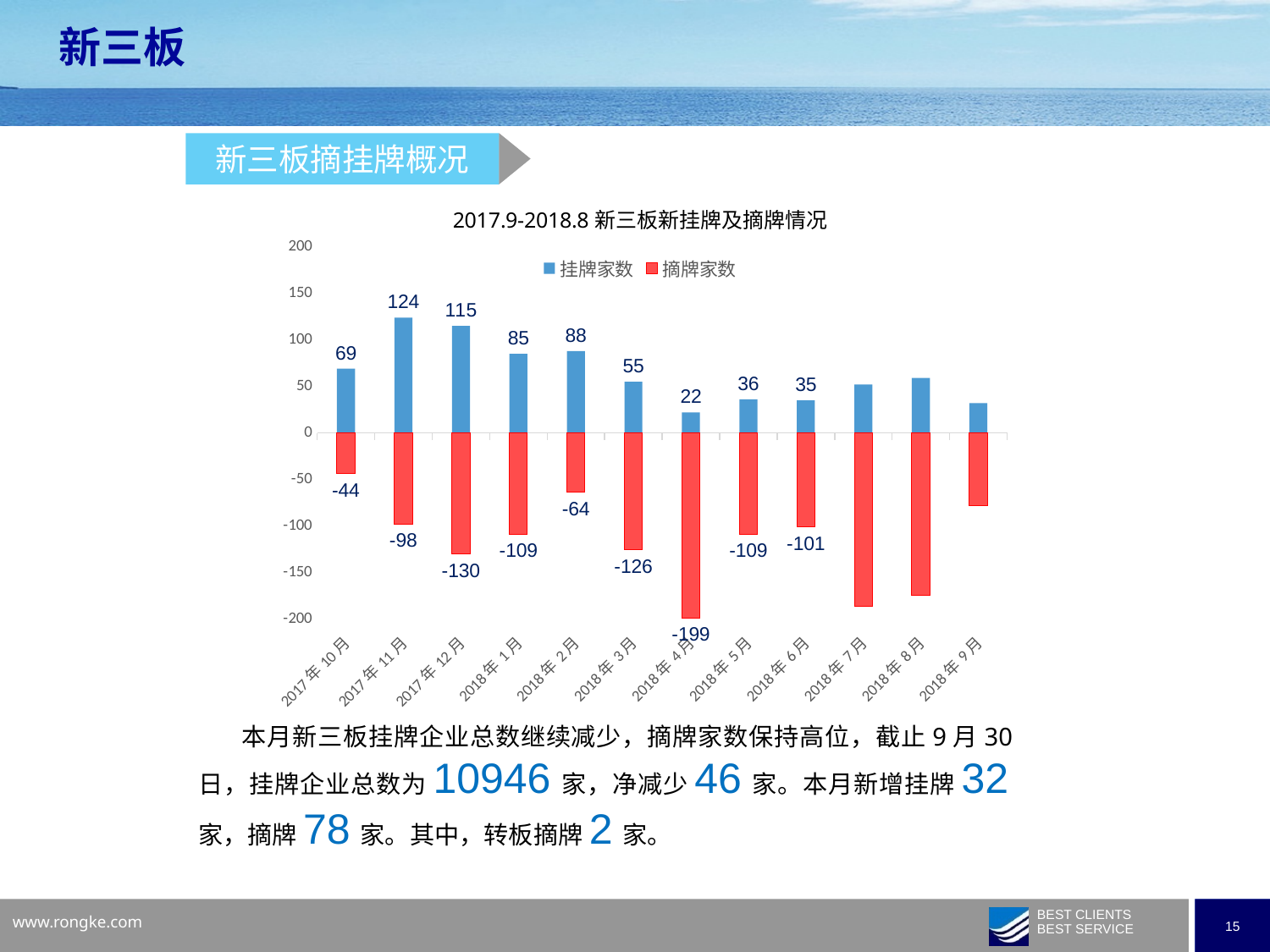
How many series does the legend list? 2 Is the 挂牌家数 value for 2018年8月 greater or less than 100? less How many months are shown on the x axis of the chart? 12 Which month has the highest 挂牌家数? 2017年11月 Which is larger, the 挂牌家数 for 2018年1月 or for 2018年2月? 2018年2月 Is the 摘牌家数 value for 2018年7月 greater or less than -150? less What kind of chart is shown on the slide? bar chart What is the 摘牌家数 value for 2018年4月? -199 What is the 摘牌家数 value for 2017年12月? -130 What is the difference between the 挂牌家数 values for 2017年11月 and 2017年12月? 9 What is the 挂牌家数 value for 2017年11月? 124 What is the title of the chart? 2017.9-2018.8 新三板新挂牌及摘牌情况